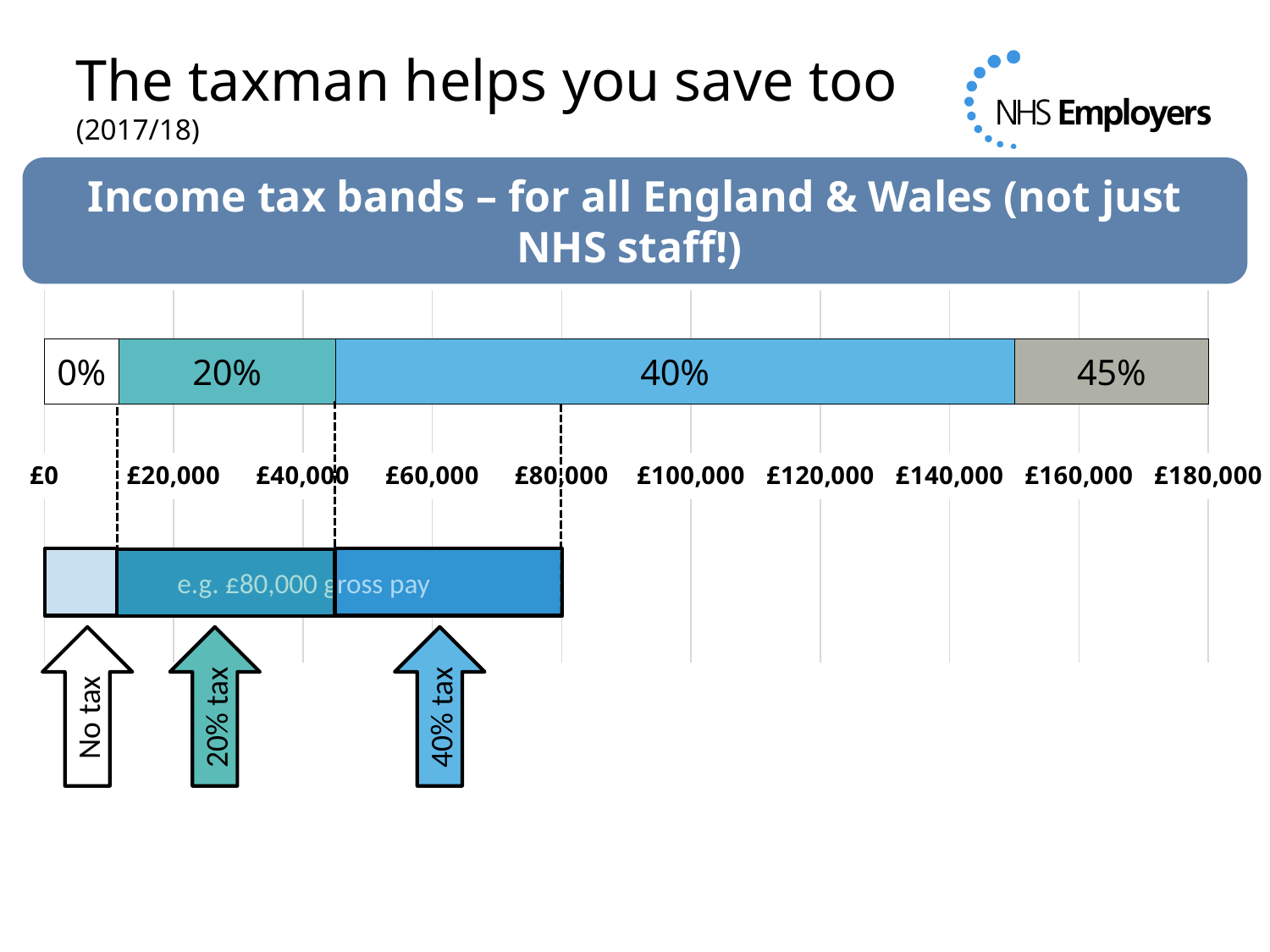
Which tax band covers the narrowest range of income in the top bar? 0% What is the highest value shown on the income axis? £180,000 Which tax rate applies to the highest incomes on the chart? 45% What is the title shown above the tax band chart? Income tax bands – for all England & Wales (not just NHS staff!) What gross pay is used in the example bar below the tax bands? £80,000 Is the upper limit of the 40% tax band greater or less than £160,000? less How many tax rate bands are shown in the top bar? 4 How many arrows are shown beneath the example gross pay bar? 3 What kind of chart is used to show the income tax bands? bar chart Is the upper limit of the 20% tax band greater or less than £40,000? greater Is the upper limit of the 40% tax band greater or less than £140,000? greater Which tax band covers the widest range of income in the top bar? 40%